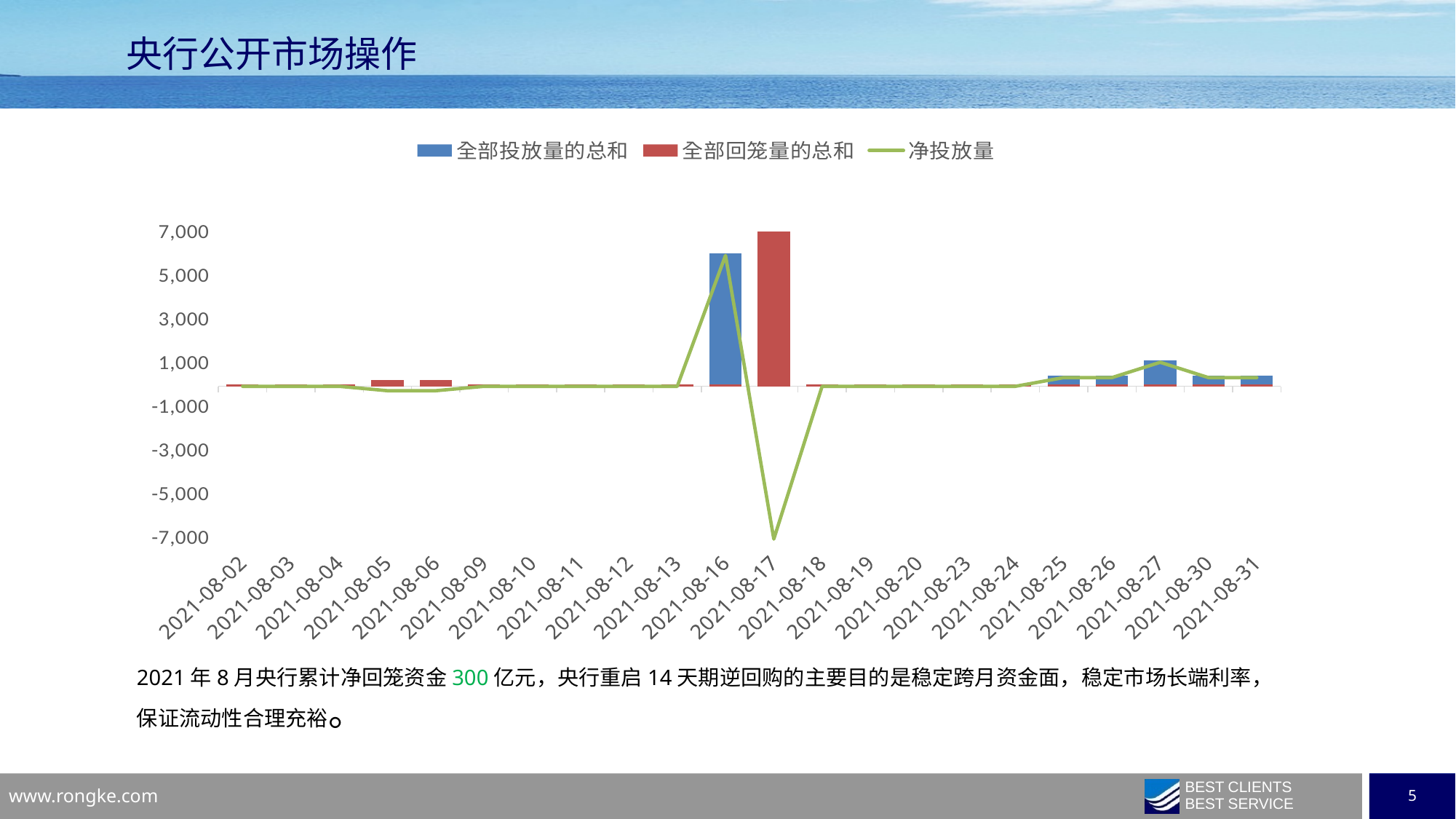
What colour represents 全部回笼量的总和 in the legend? Red Which date has the larger 全部投放量的总和 bar, 2021-08-25 or 2021-08-27? 2021-08-27 Is the 全部投放量的总和 value for 2021-08-27 greater or less than 3,000? less How many dates are shown along the x axis? 22 How many series does the legend list? 3 Is the 全部回笼量的总和 value for 2021-08-17 greater or less than 5,000? greater On which date does the 净投放量 line reach its lowest point? 2021-08-17 On which date is the 全部投放量的总和 bar the highest? 2021-08-16 On which date is the 全部回笼量的总和 bar the highest? 2021-08-17 What kind of chart is shown on the slide? A combination bar and line chart Is the 净投放量 value for 2021-08-17 greater or less than -5,000? less